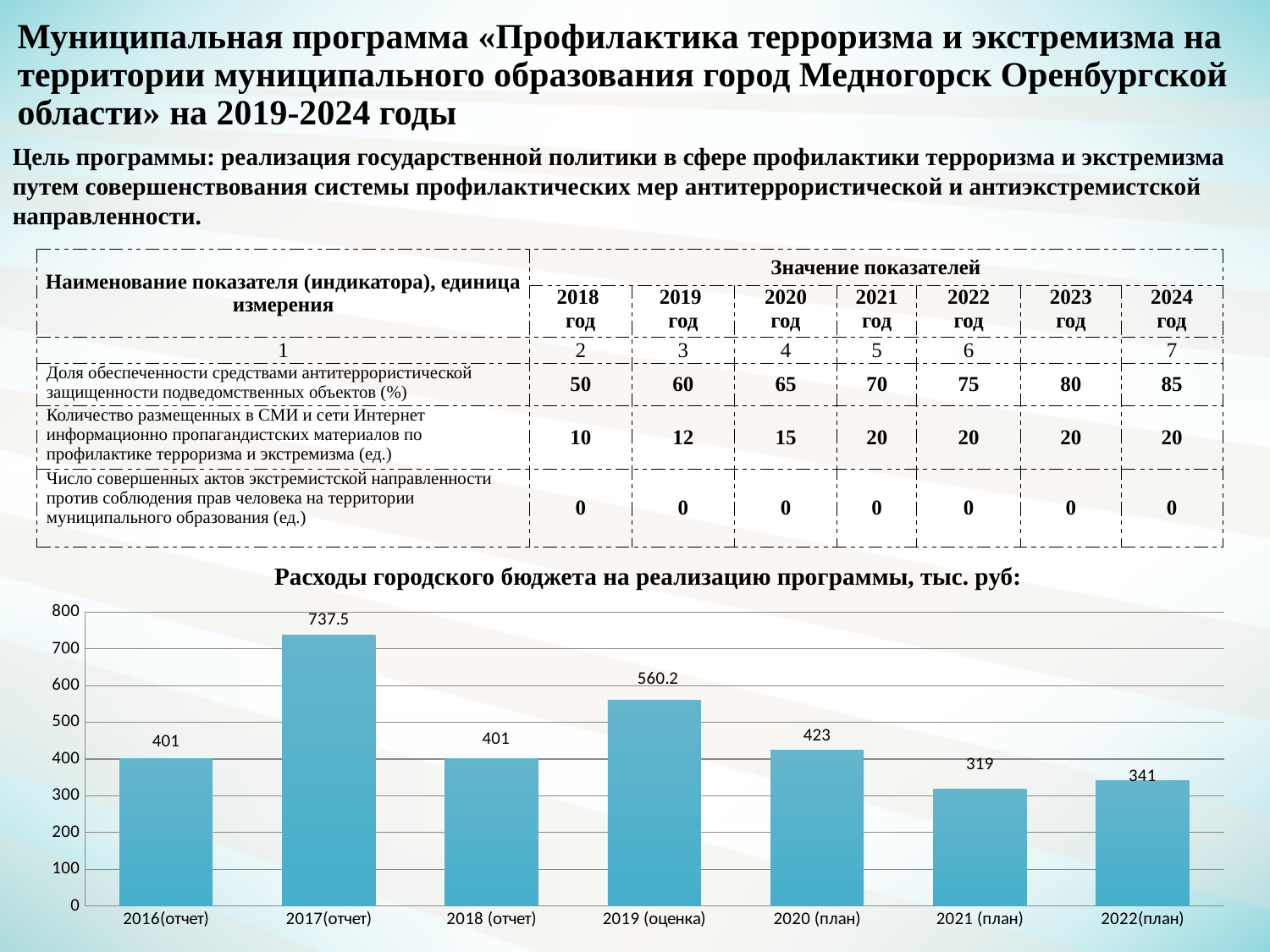
What is the value for 2019 (оценка) in the chart? 560.2 What is the value for 2021 (план) in the chart? 319 Which category has the lowest value in the chart? 2021 (план) What is the value for 2022(план) in the chart? 341 Which category has the highest value in the chart? 2017(отчет) What is the value for 2017(отчет) in the chart? 737.5 How many categories are shown on the x axis of the chart? 7 What type of chart is shown on the slide? bar chart Which is larger, the value for 2020 (план) or the value for 2022(план)? 2020 (план) Is the value for 2019 (оценка) greater or less than 500? greater What is the difference between the values for 2017(отчет) and 2016(отчет)? 336.5 What is the title of the chart? Расходы городского бюджета на реализацию программы, тыс. руб: